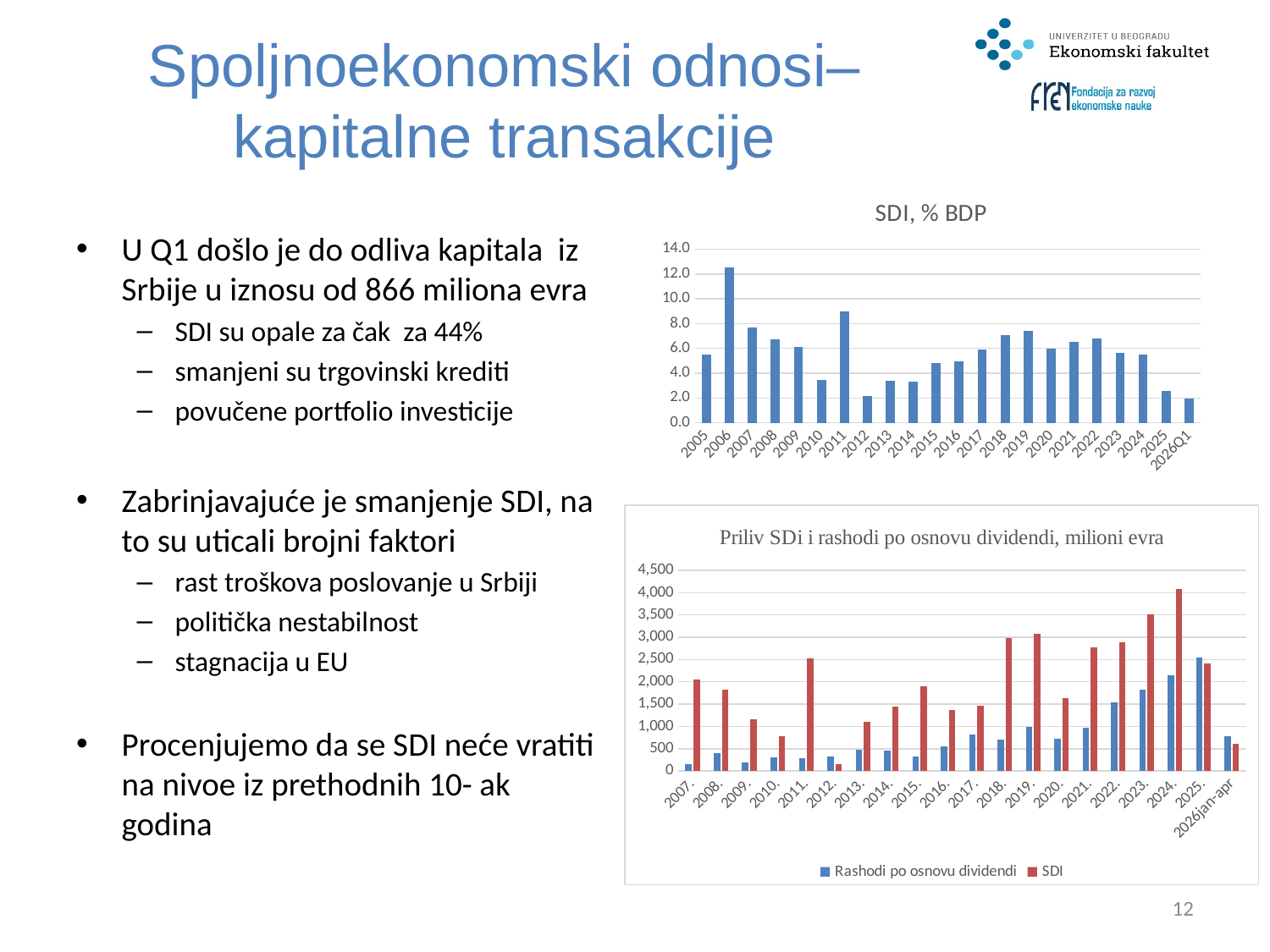
How many bars are shown in the 'SDI, % BDP' chart? 22 How many series does the legend of the 'Priliv SDi i rashodi po osnovu dividendi, milioni evra' chart list? 2 In the 'SDI, % BDP' chart, is the value for 2011 greater or less than 8.0? greater What type of chart is the 'SDI, % BDP' chart? bar chart In the 'Priliv SDi i rashodi po osnovu dividendi, milioni evra' chart, which year has the highest SDI value? 2024. In the 'SDI, % BDP' chart, which is larger, the value for 2019 or the value for 2012? 2019 In the 'SDI, % BDP' chart, is the value for 2006 greater or less than 10.0? greater In the 'SDI, % BDP' chart, is the value for 2025 greater or less than 4.0? less In the 'Priliv SDi i rashodi po osnovu dividendi, milioni evra' chart, which series is larger in 2024, Rashodi po osnovu dividendi or SDI? SDI In the 'Priliv SDi i rashodi po osnovu dividendi, milioni evra' chart, what colour are the SDI bars? red In the 'SDI, % BDP' chart, which year has the highest value? 2006